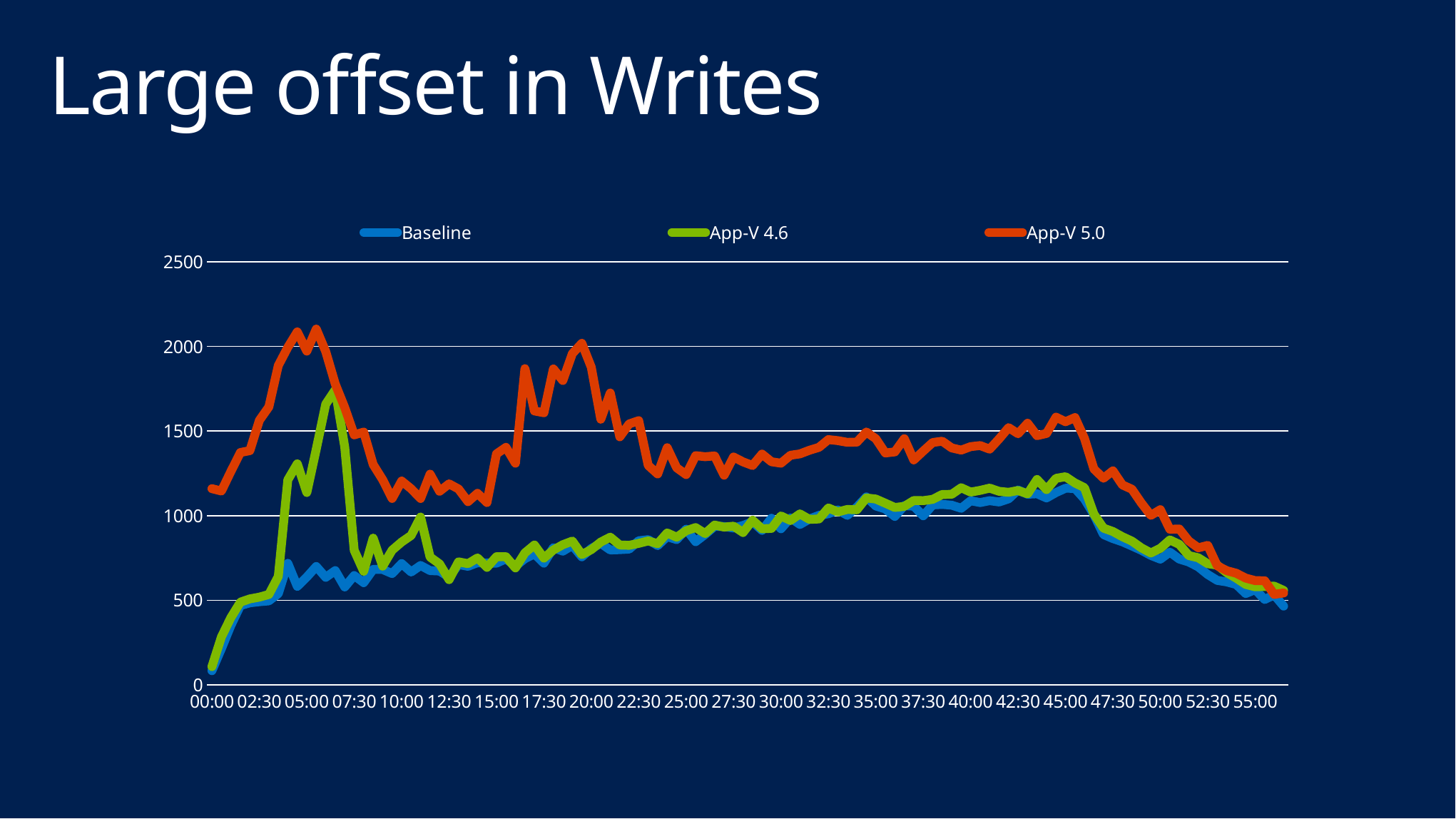
Which series is drawn in red? App-V 5.0 How many series does the legend list? 3 Is the value for App-V 5.0 at 00:00 greater or less than 1000? greater What kind of chart is shown on the slide? line chart At 20:00, which series has the larger value, App-V 5.0 or Baseline? App-V 5.0 At 07:30, which series has the larger value, App-V 4.6 or Baseline? App-V 4.6 Is the value for Baseline at 00:00 greater or less than 500? less Does the Baseline series generally rise or fall between 15:00 and 45:00? rise Is the value for App-V 5.0 at 17:30 greater or less than 1500? greater What is the title of the slide? Large offset in Writes Which series reaches the highest value anywhere on the chart? App-V 5.0